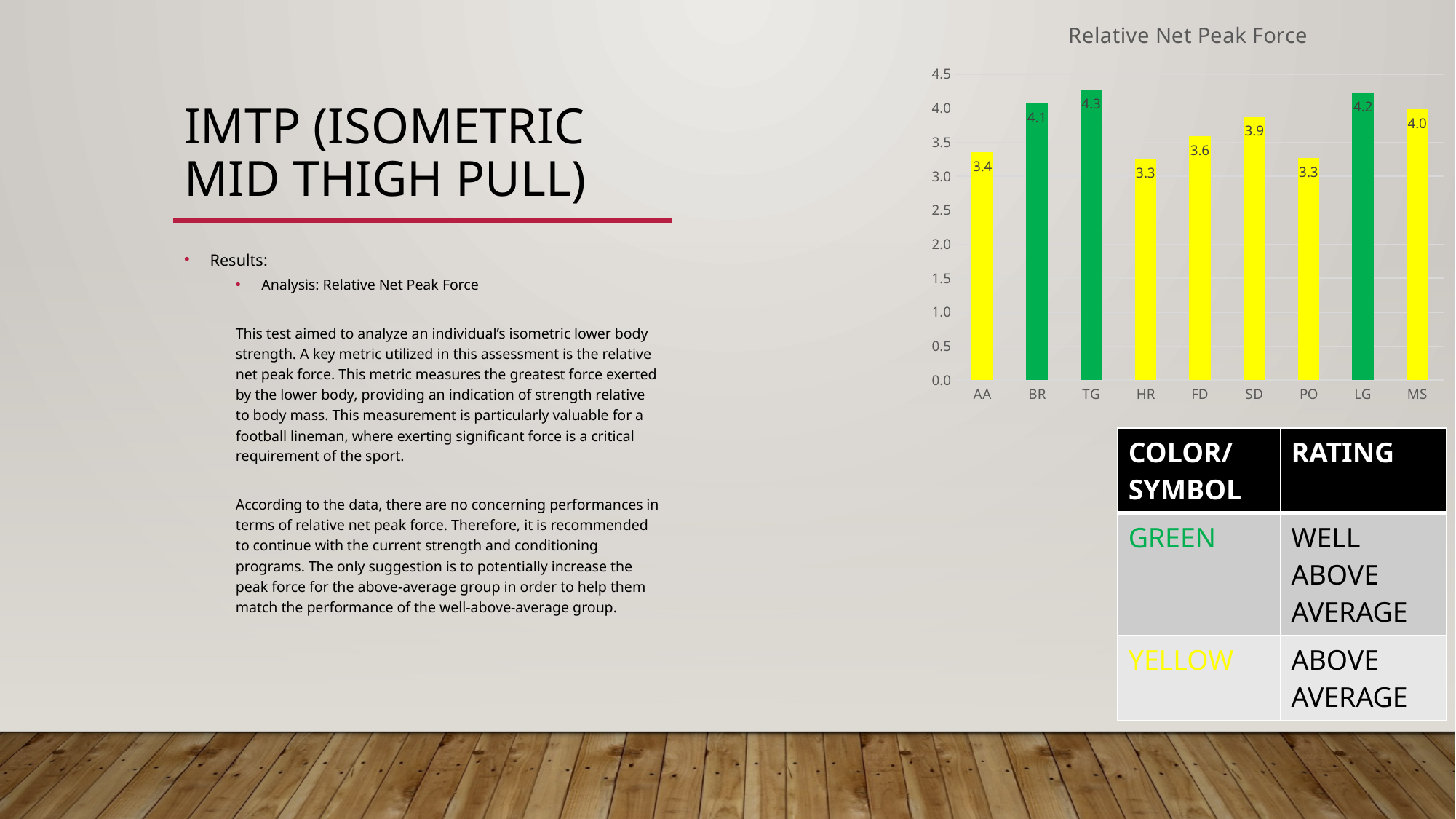
What kind of chart is used to show Relative Net Peak Force? bar chart Which category has the highest Relative Net Peak Force? TG Which has a larger Relative Net Peak Force, SD or HR? SD What is the Relative Net Peak Force value for SD? 3.9 Is the value for PO greater or less than 3.5? less What is the Relative Net Peak Force value for MS? 4.0 What is the Relative Net Peak Force value for TG? 4.3 What is the difference between the Relative Net Peak Force values for TG and AA? 0.9 How many categories are shown on the x axis of the Relative Net Peak Force chart? 9 What colour are the bars for BR, TG and LG in the Relative Net Peak Force chart? green Which has a larger Relative Net Peak Force, BR or FD? BR What is the difference between the Relative Net Peak Force values for LG and FD? 0.6